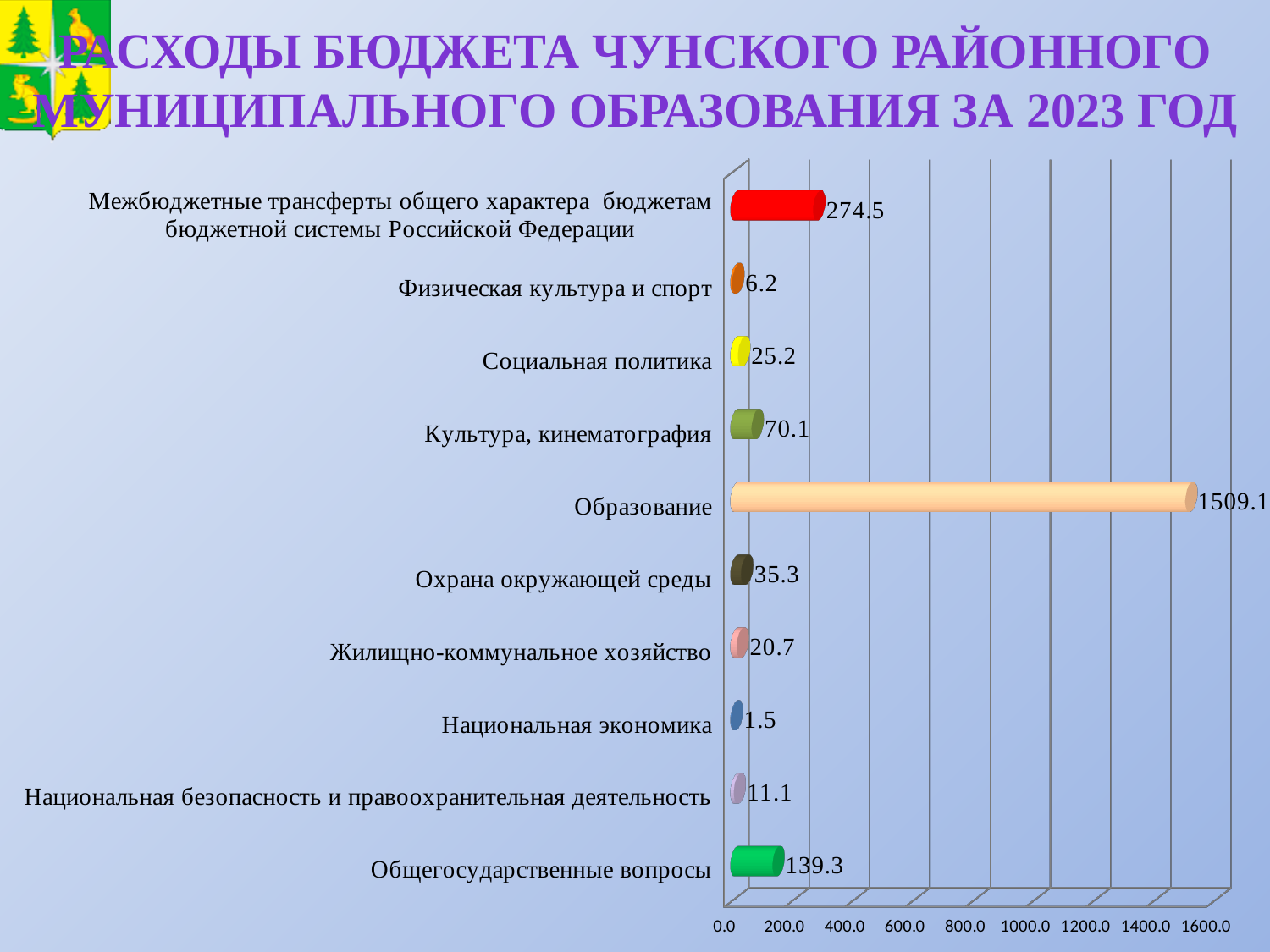
What is the difference between the values for Социальная политика and Жилищно-коммунальное хозяйство? 4.5 Which category has the lowest value? Национальная экономика Is the value for Образование greater or less than 1400.0? greater What is the value for Межбюджетные трансферты общего характера бюджетам бюджетной системы Российской Федерации? 274.5 What kind of chart is shown on the slide? Bar chart Which category has the highest value? Образование Which is larger, the value for Охрана окружающей среды or the value for Физическая культура и спорт? Охрана окружающей среды What is the value for Культура, кинематография? 70.1 What is the value for Общегосударственные вопросы? 139.3 What is the difference between the values for Образование and Общегосударственные вопросы? 1369.8 How many categories are shown in the chart? 10 What is the value for Образование? 1509.1